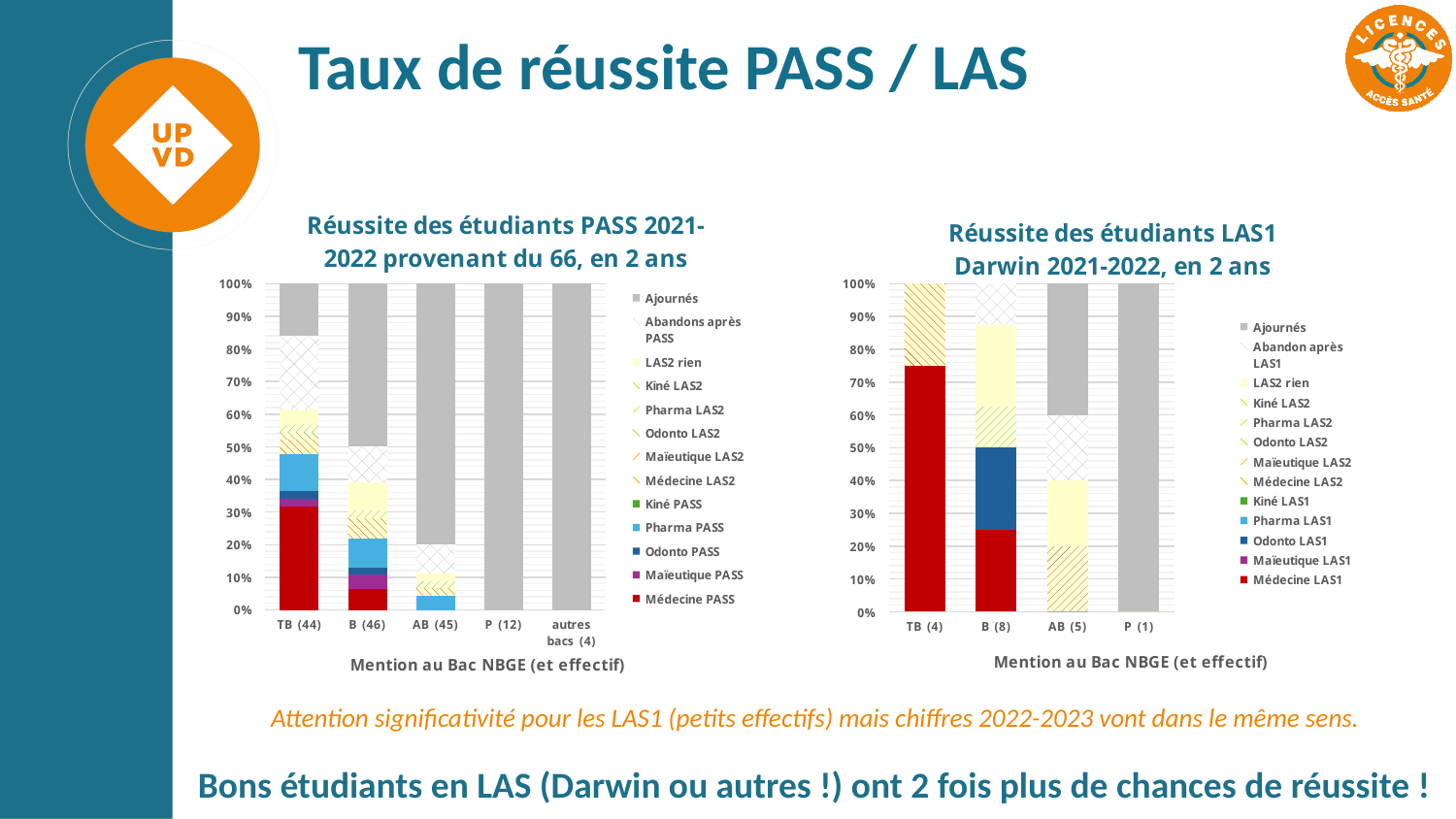
What kind of chart is the 'Réussite des étudiants PASS 2021-2022 provenant du 66, en 2 ans' chart? Stacked bar chart In the left chart (Réussite des étudiants PASS 2021-2022), is the Ajournés share for AB (45) greater or less than 70%? greater In the left chart (Réussite des étudiants PASS 2021-2022), is the value of Médecine PASS for TB (44) greater or less than 30%? greater In the right chart (Réussite des étudiants LAS1 Darwin 2021-2022), is the value of Médecine LAS1 for TB (4) greater or less than 70%? greater How many categories are shown on the x axis of the right chart (Réussite des étudiants LAS1 Darwin 2021-2022)? 4 How many series does the legend of the left chart (Réussite des étudiants PASS 2021-2022) list? 13 In the left chart (Réussite des étudiants PASS 2021-2022), what is the value of Ajournés for P (12)? 100% In the right chart (Réussite des étudiants LAS1 Darwin 2021-2022), which category has the larger Médecine LAS1 share, TB (4) or B (8)? TB (4) In the left chart (Réussite des étudiants PASS 2021-2022), does the Médecine PASS share rise or fall from TB (44) to P (12)? Fall In the right chart (Réussite des étudiants LAS1 Darwin 2021-2022), what is the value of Ajournés for P (1)? 100% What is the x-axis title of the right chart (Réussite des étudiants LAS1 Darwin 2021-2022)? Mention au Bac NBGE (et effectif) How many categories are shown on the x axis of the left chart (Réussite des étudiants PASS 2021-2022)? 5